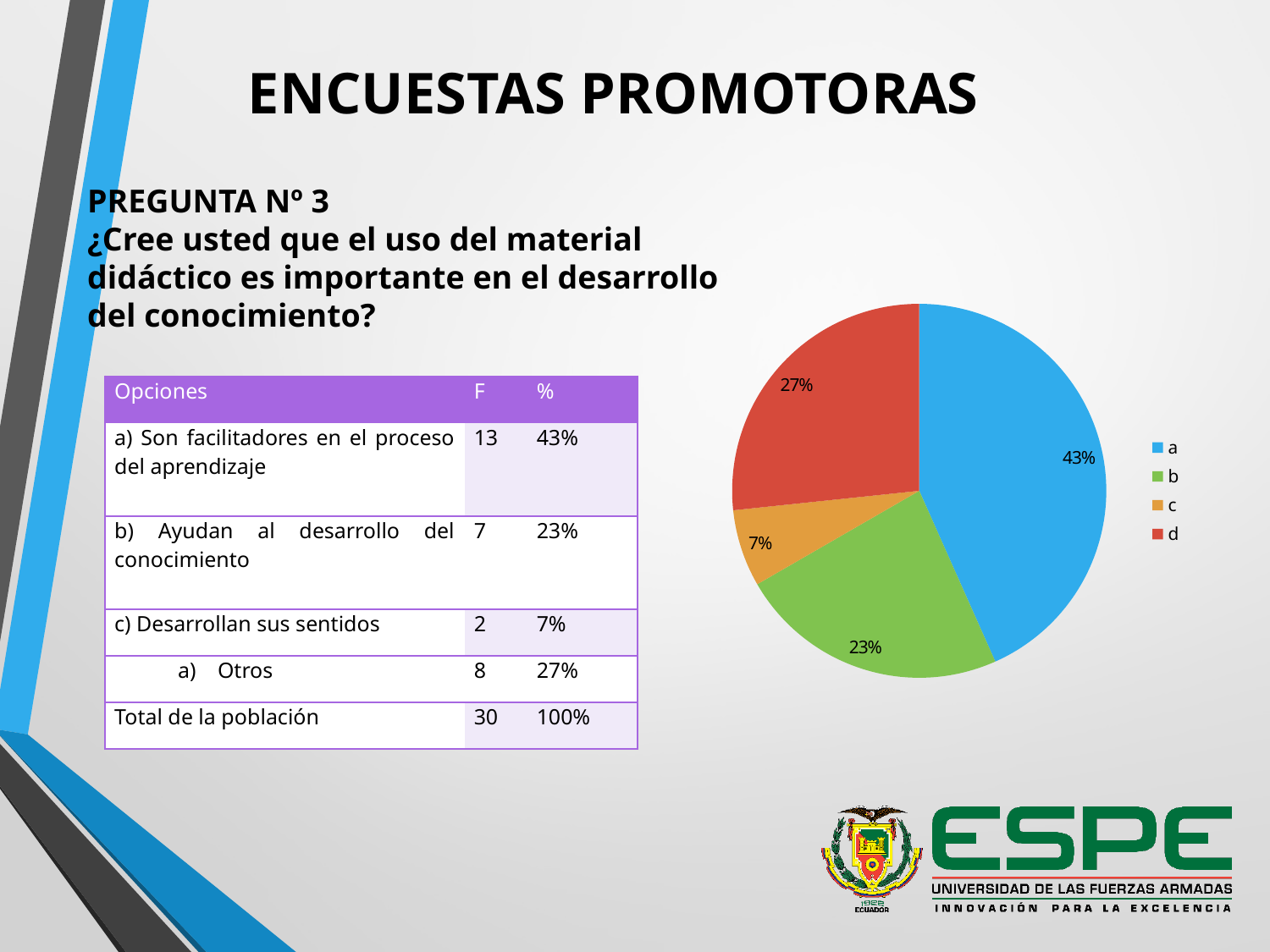
What percentage does slice c represent in the pie chart? 7% What percentage does slice d represent in the pie chart? 27% What percentage does slice a represent in the pie chart? 43% How many slices does the pie chart have? 4 Which is larger in the pie chart, slice b or slice d? d Which slice of the pie chart is the largest? a Which slice of the pie chart is the smallest? c What is the difference in percentage points between slice a and slice d in the pie chart? 16 What percentage does slice b represent in the pie chart? 23% What kind of chart is shown on the slide? pie chart How many entries does the legend of the pie chart list? 4 What colour is slice a in the pie chart? blue